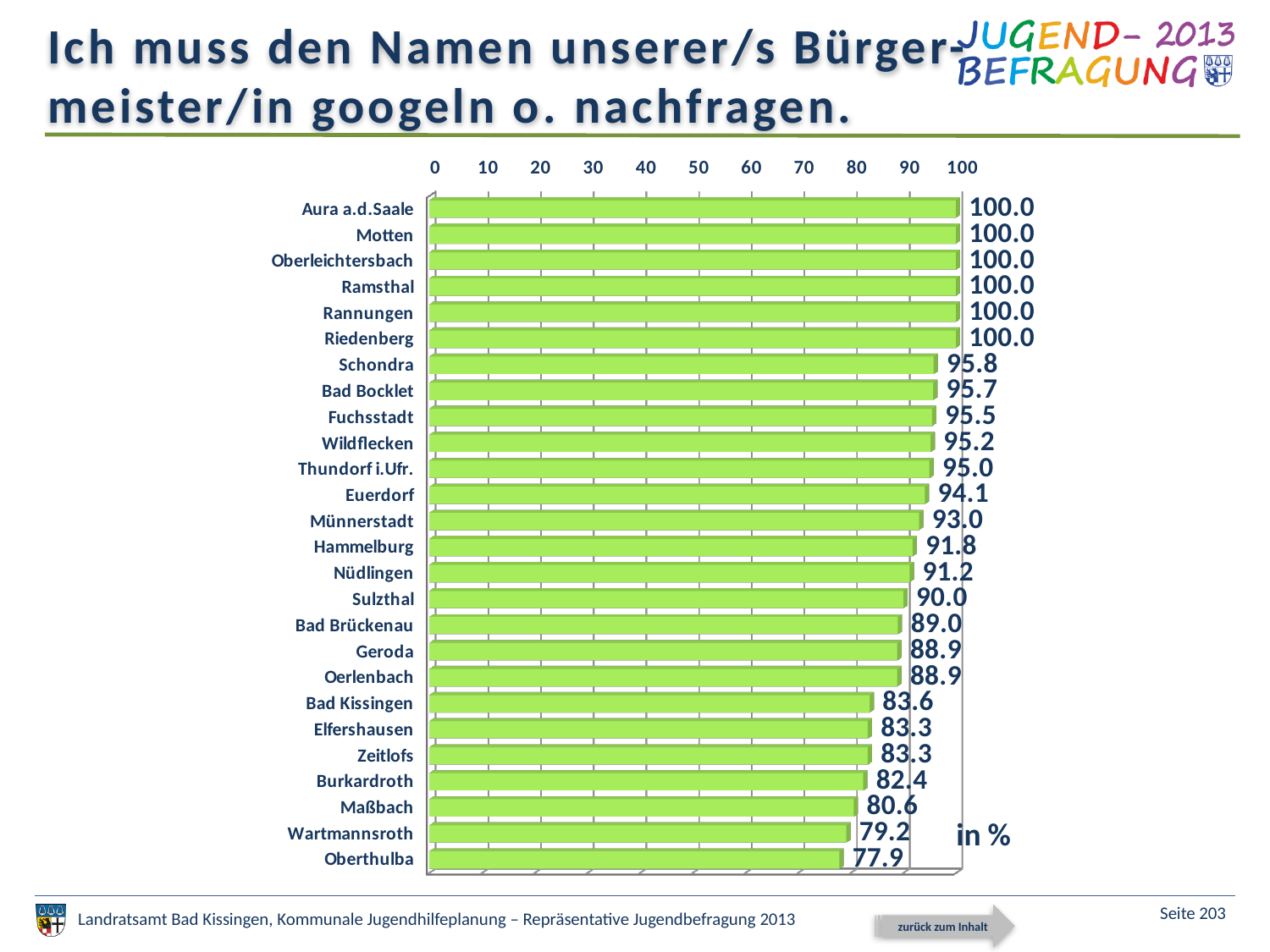
What is the value for Hammelburg? 91.8 What is the value for Bad Kissingen? 83.6 What is the value for Wartmannsroth? 79.2 Which is larger, the value for Euerdorf or the value for Geroda? Euerdorf Is the value for Burkardroth greater or less than 90? less What unit is indicated for the values in the chart? % What is the difference between the values for Aura a.d.Saale and Oberthulba? 22.1 What is the value for Schondra? 95.8 What is the difference between the values for Sulzthal and Maßbach? 9.4 How many categories are shown in the chart? 26 Which category has the lowest value? Oberthulba What kind of chart is shown on the slide? bar chart